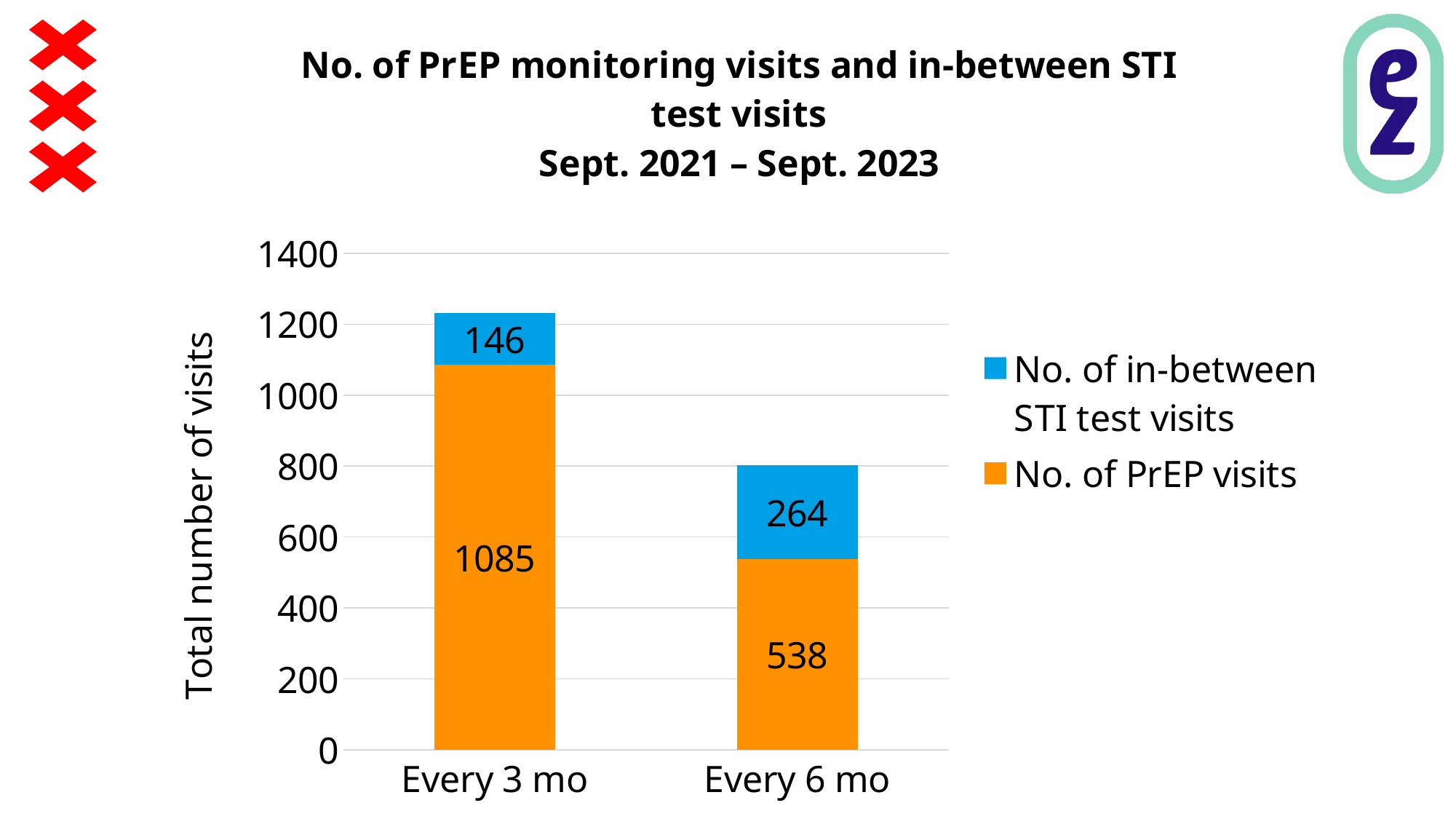
What is the number of in-between STI test visits for the Every 6 mo group? 264 What is the number of in-between STI test visits for the Every 3 mo group? 146 What is the total number of visits for the Every 3 mo group? 1231 What is the number of PrEP visits for the Every 3 mo group? 1085 Which group has the higher number of PrEP visits? Every 3 mo What is the total number of visits for the Every 6 mo group? 802 How many series does the legend list? 2 What kind of chart is shown on the slide? Stacked bar chart What is the number of PrEP visits for the Every 6 mo group? 538 What is the difference in the number of PrEP visits between the Every 3 mo and Every 6 mo groups? 547 Which group has the lower number of in-between STI test visits? Every 3 mo What is the label of the vertical axis? Total number of visits